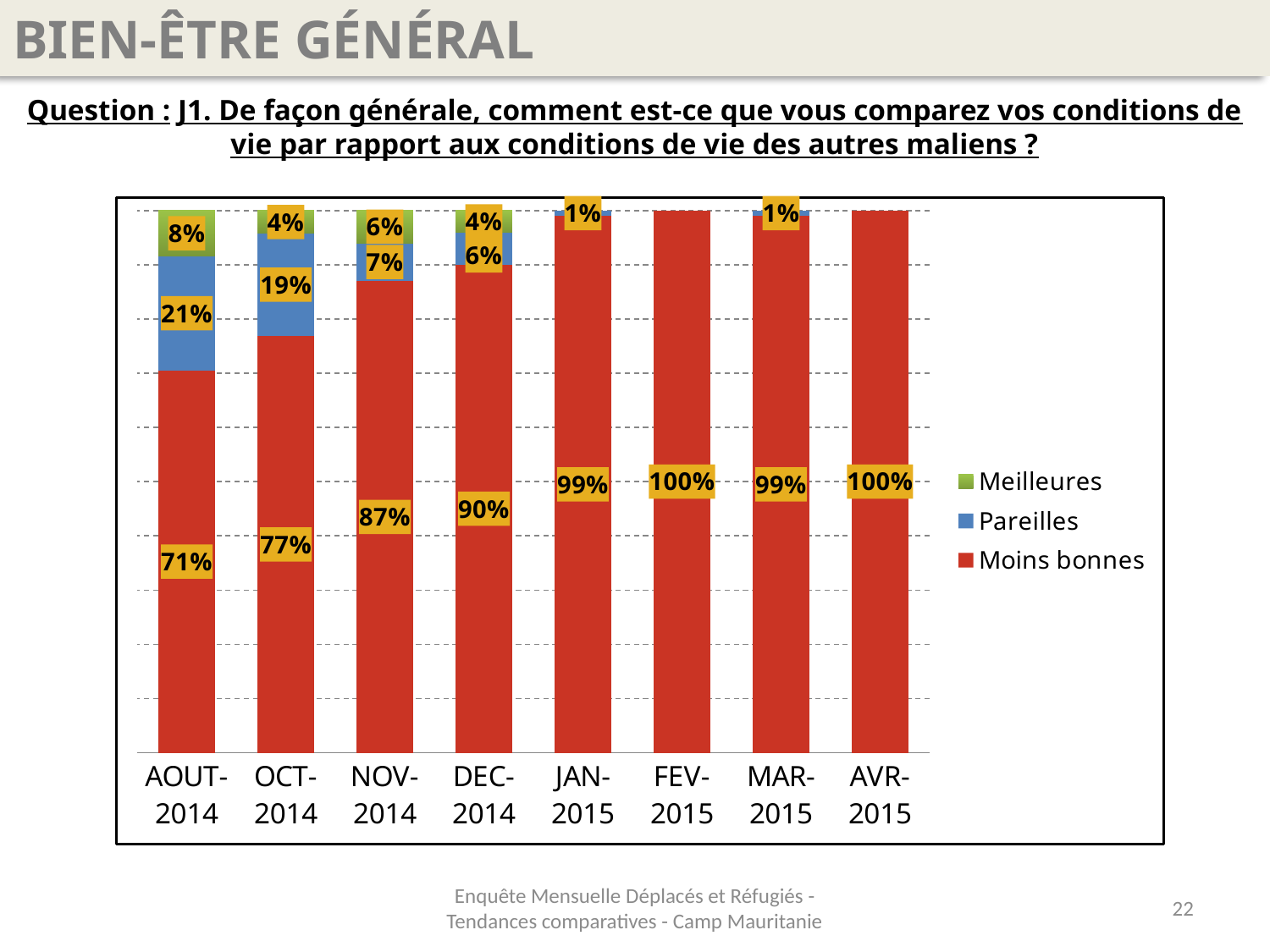
How many months (categories) are shown on the x axis? 8 What is the value of "Meilleures" for NOV-2014? 6% What is the value of "Moins bonnes" for AOUT-2014? 71% In which month is the "Moins bonnes" value lowest? AOUT-2014 What is the difference between the "Moins bonnes" values for OCT-2014 and AOUT-2014? 6% Does the "Moins bonnes" value rise or fall from AOUT-2014 to AVR-2015? rise What is the value of "Moins bonnes" for DEC-2014? 90% Which is larger: the "Pareilles" value for NOV-2014 or for DEC-2014? NOV-2014 What is the value of "Pareilles" for OCT-2014? 19% What type of chart is shown on the slide? stacked bar chart In which month is the "Pareilles" value highest? AOUT-2014 How many series does the legend list? 3